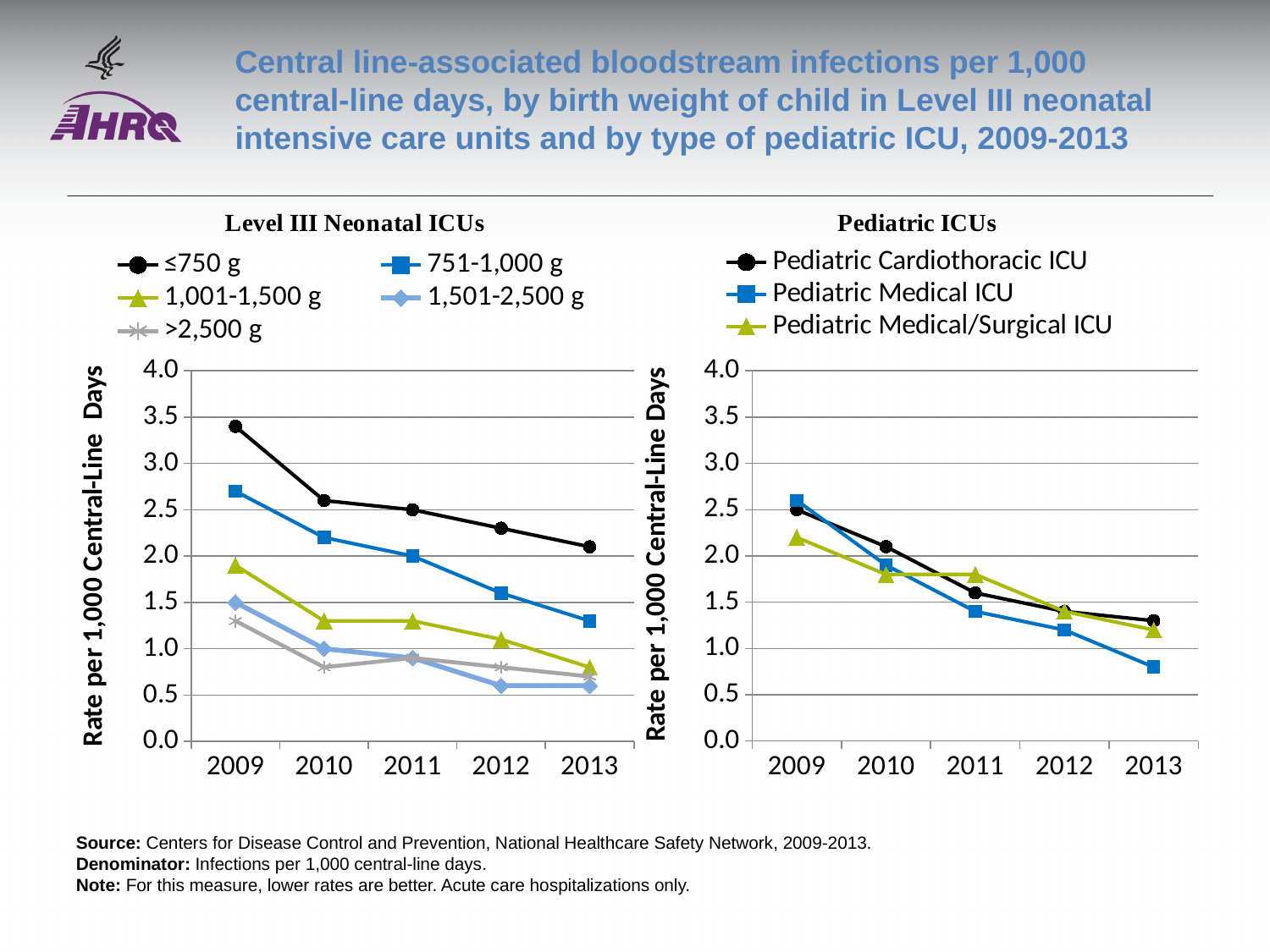
In the Level III Neonatal ICUs chart, which birth weight group has the highest rate in 2009? ≤750 g In the Level III Neonatal ICUs chart, what is the rate for 1,501-2,500 g in 2009? 1.5 How many series does the legend of the Pediatric ICUs chart list? 3 How many series does the legend of the Level III Neonatal ICUs chart list? 5 In the Pediatric ICUs chart, which ICU type has the lowest rate in 2013? Pediatric Medical ICU In the Level III Neonatal ICUs chart, what kind of chart is shown? line chart In the Level III Neonatal ICUs chart, does the rate for 751-1,000 g rise or fall from 2009 to 2013? fall In the Level III Neonatal ICUs chart, what is the rate for ≤750 g in 2011? 2.5 In the Pediatric ICUs chart, what is the rate for Pediatric Cardiothoracic ICU in 2009? 2.5 In the Pediatric ICUs chart, is the rate for Pediatric Medical ICU in 2013 greater or less than 1.0? less In the Level III Neonatal ICUs chart, is the rate for ≤750 g in 2009 greater or less than 3.0? greater In the Level III Neonatal ICUs chart, how many years are shown on the x axis? 5